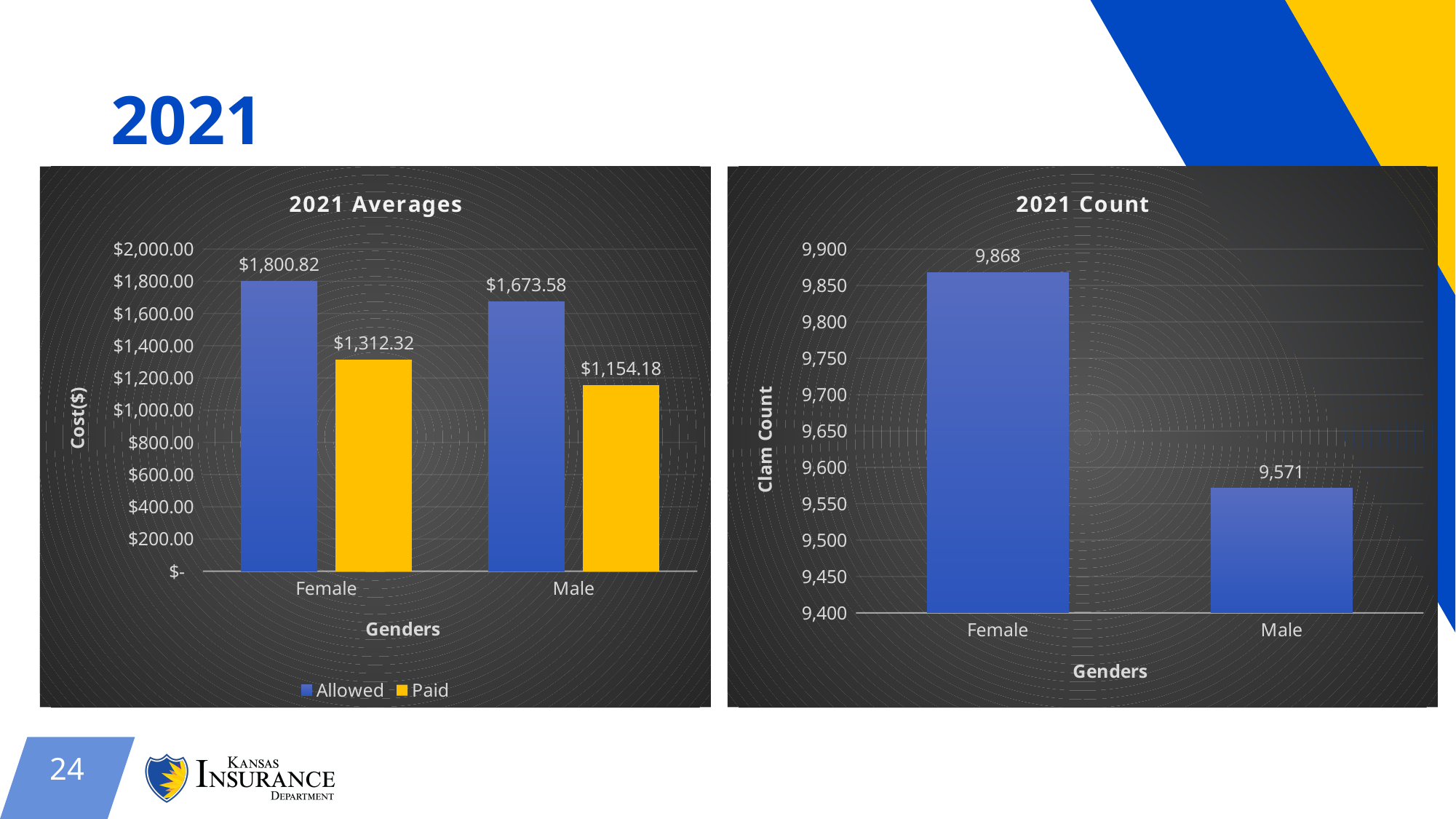
In the '2021 Averages' chart, which colour represents the Paid series? Yellow In the '2021 Count' chart, which gender has the lowest claim count? Male In the '2021 Averages' chart, what is the Allowed value for Female? $1,800.82 In the '2021 Count' chart, what is the claim count for Female? 9,868 In the '2021 Averages' chart, what is the Paid value for Male? $1,154.18 In the '2021 Averages' chart, how many series does the legend list? 2 In the '2021 Averages' chart, which gender has the higher Allowed value? Female In the '2021 Averages' chart, what is the Paid value for Female? $1,312.32 In the '2021 Count' chart, what is the claim count for Male? 9,571 What kind of chart is the '2021 Count' chart? Bar chart In the '2021 Averages' chart, what is the difference between the Allowed and Paid values for Male? $519.40 In the '2021 Count' chart, what is the difference between the Female and Male claim counts? 297